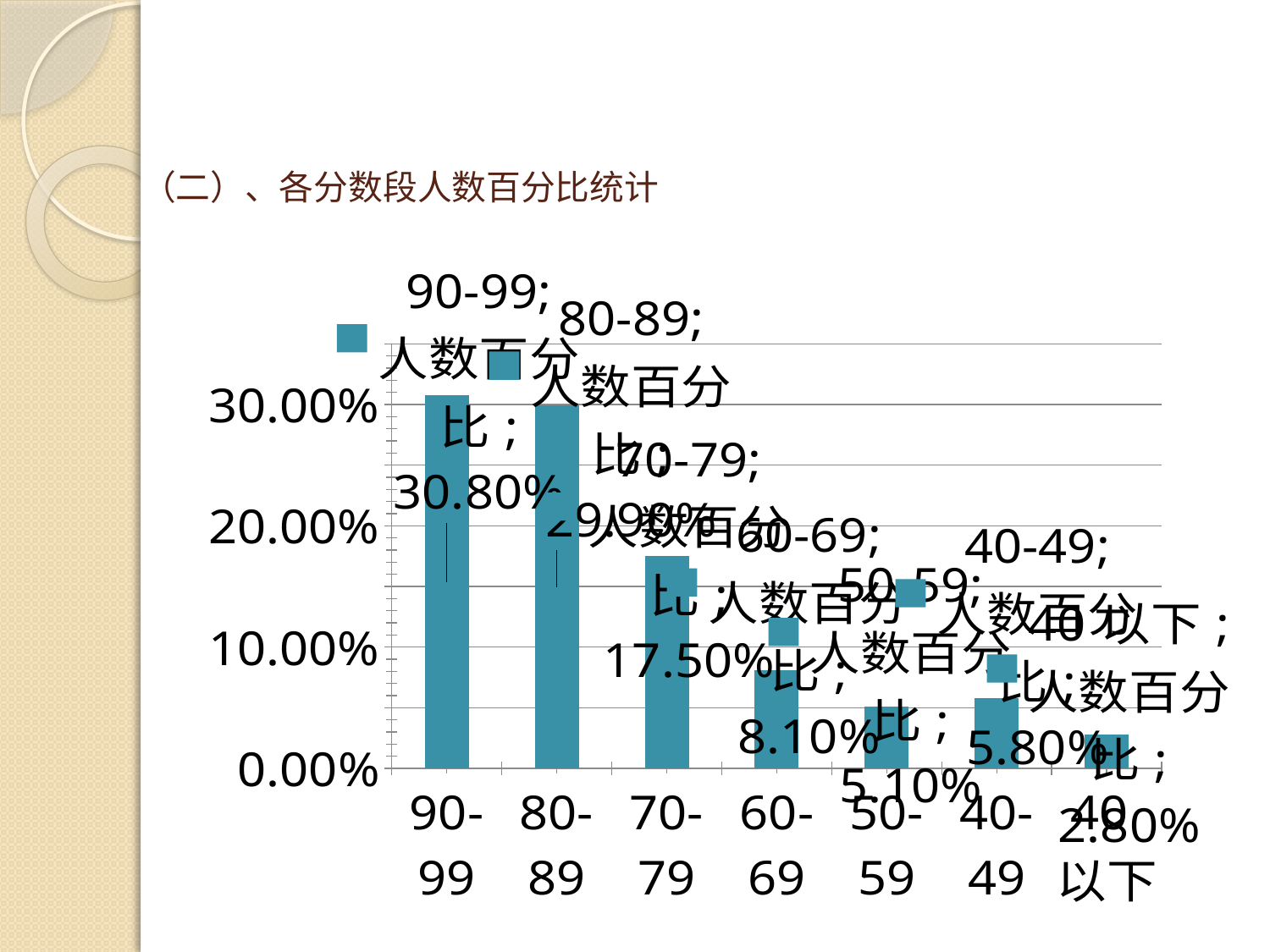
What is the difference between the values for 90-99 and 70-79? 13.30% What is the value for the 40-49 score range? 5.80% Which is larger, the value for 40-49 or the value for 50-59? 40-49 What is the value for the 50-59 score range? 5.10% What is the value for the 40以下 category? 2.80% Which score range has the highest percentage? 90-99 What is the value for the 90-99 score range? 30.80% What kind of chart is shown on the slide? bar chart What is the value for the 70-79 score range? 17.50% How many score categories are shown on the x axis? 7 Which category has the lowest percentage? 40以下 What is the value for the 60-69 score range? 8.10%